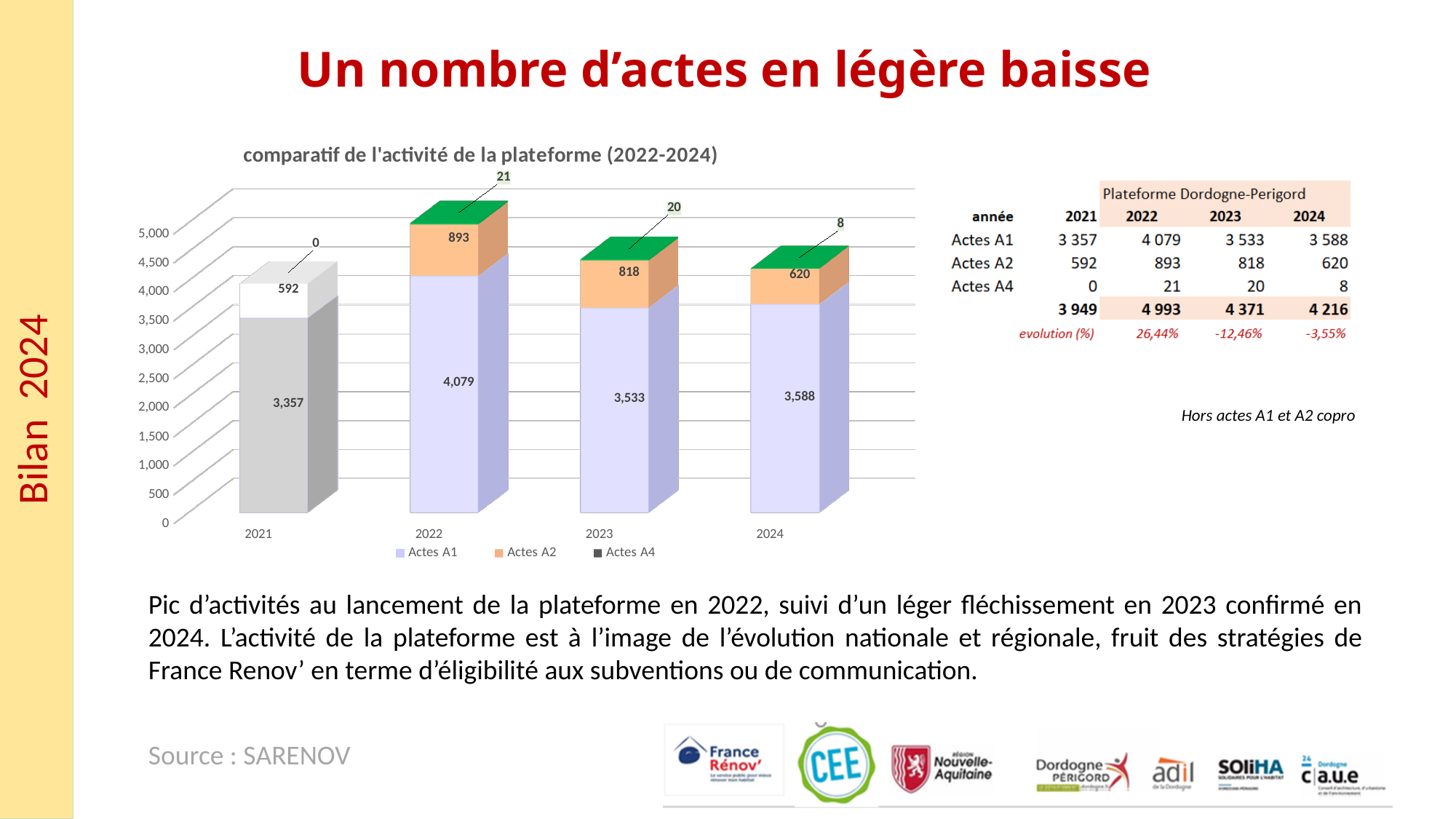
How many years are shown on the x axis? 4 Which year has the lowest value for Actes A2? 2021 What is the title of the chart? comparatif de l'activité de la plateforme (2022-2024) Which year has the highest value for Actes A1? 2022 What is the total of the stacked bar for 2022? 4,993 What kind of chart is shown? Stacked bar chart Which is larger, the Actes A2 value for 2022 or for 2024? 2022 What is the value for Actes A1 in 2022? 4,079 What is the value for Actes A2 in 2023? 818 What is the value for Actes A4 in 2024? 8 How many series does the legend list? 3 What is the difference between the Actes A1 values for 2022 and 2023? 546